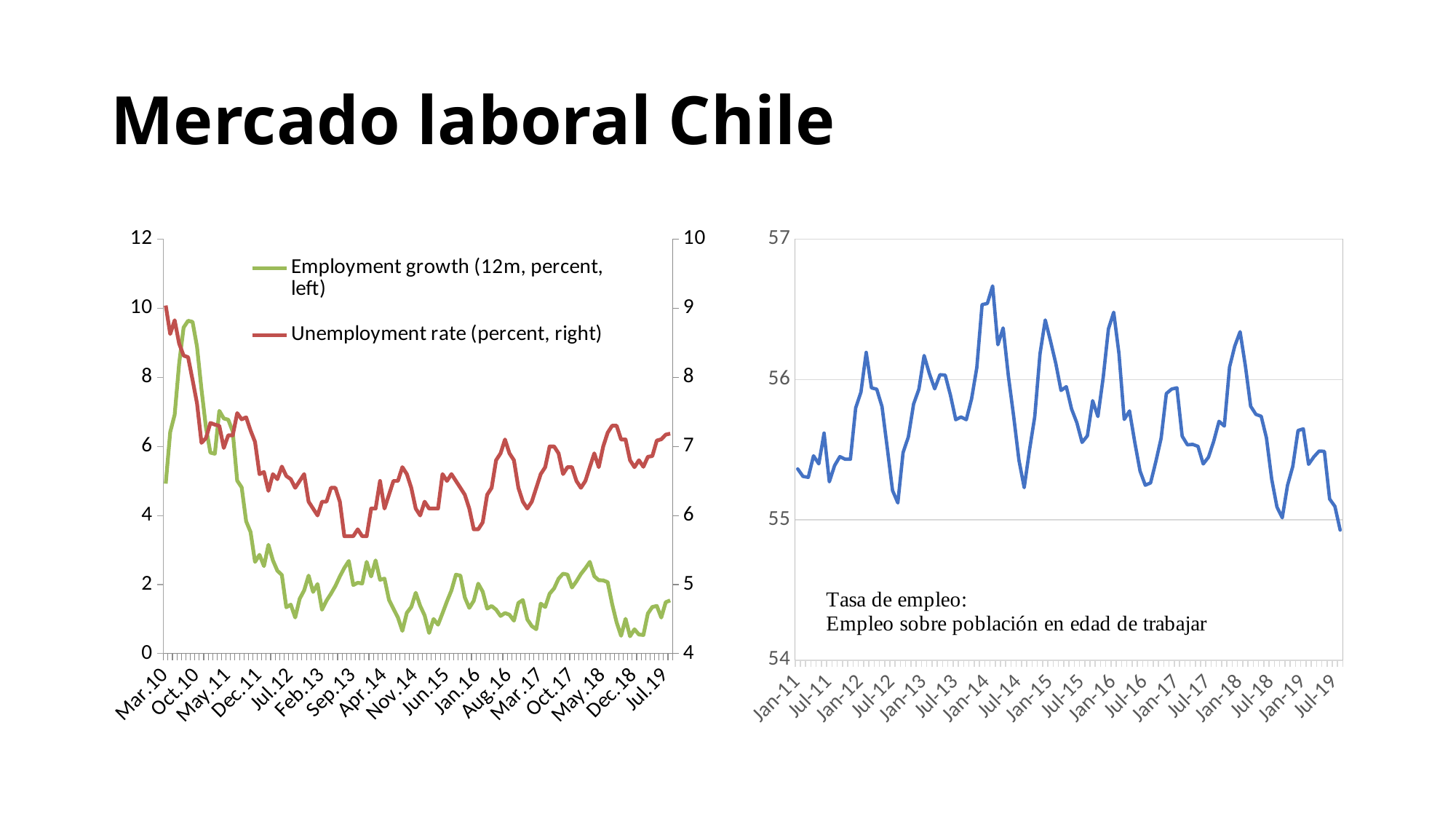
In the left chart, is the Employment growth value at Jul.19 greater or less than 2? less What kind of chart is the right chart (Tasa de empleo)? Line chart In the left chart, which series is plotted against the right axis? Unemployment rate (percent, right) In the left chart, what colour is the Employment growth line? Green In the left chart, is the Unemployment rate at Mar.10 greater or less than 8? greater What kind of chart is the left chart on the slide? Line chart How many series does the legend of the left chart list? 2 In the left chart, is the Unemployment rate at Sep.13 greater or less than 6? less In the left chart, does the Employment growth line overall rise or fall from Mar.10 to Jul.19? Fall